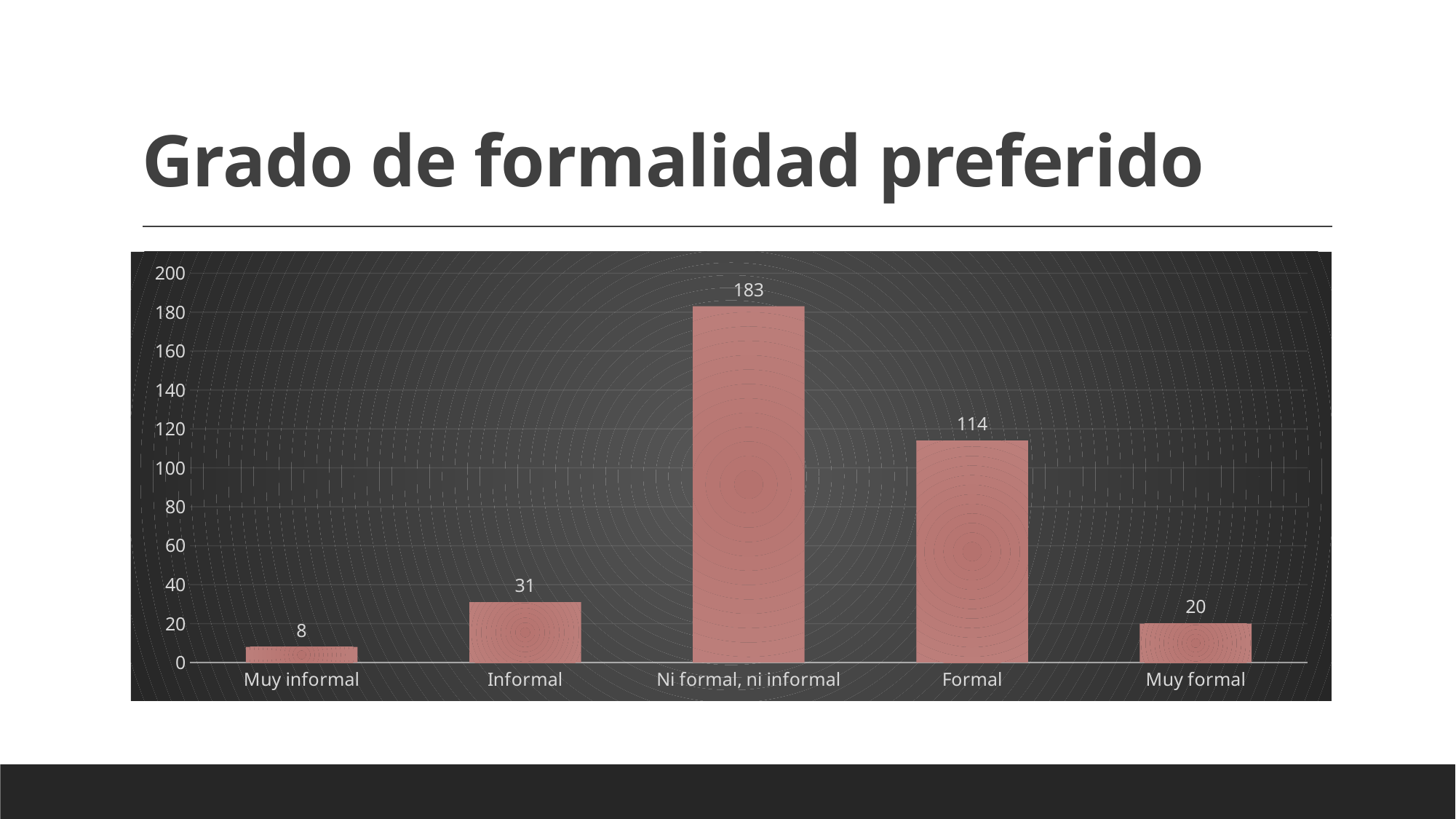
What is the difference between the values for "Ni formal, ni informal" and "Formal"? 69 Which category has the lowest value? Muy informal Is the value for "Formal" greater or less than 100? greater What is the value for "Ni formal, ni informal"? 183 Which category has the highest value? Ni formal, ni informal What is the value for "Muy informal"? 8 What is the value for "Muy formal"? 20 Which is larger, the value for "Informal" or the value for "Muy formal"? Informal What is the title of the slide containing the chart? Grado de formalidad preferido How many categories are shown on the x axis? 5 What kind of chart is shown on the slide? Bar chart What is the value for "Formal"? 114